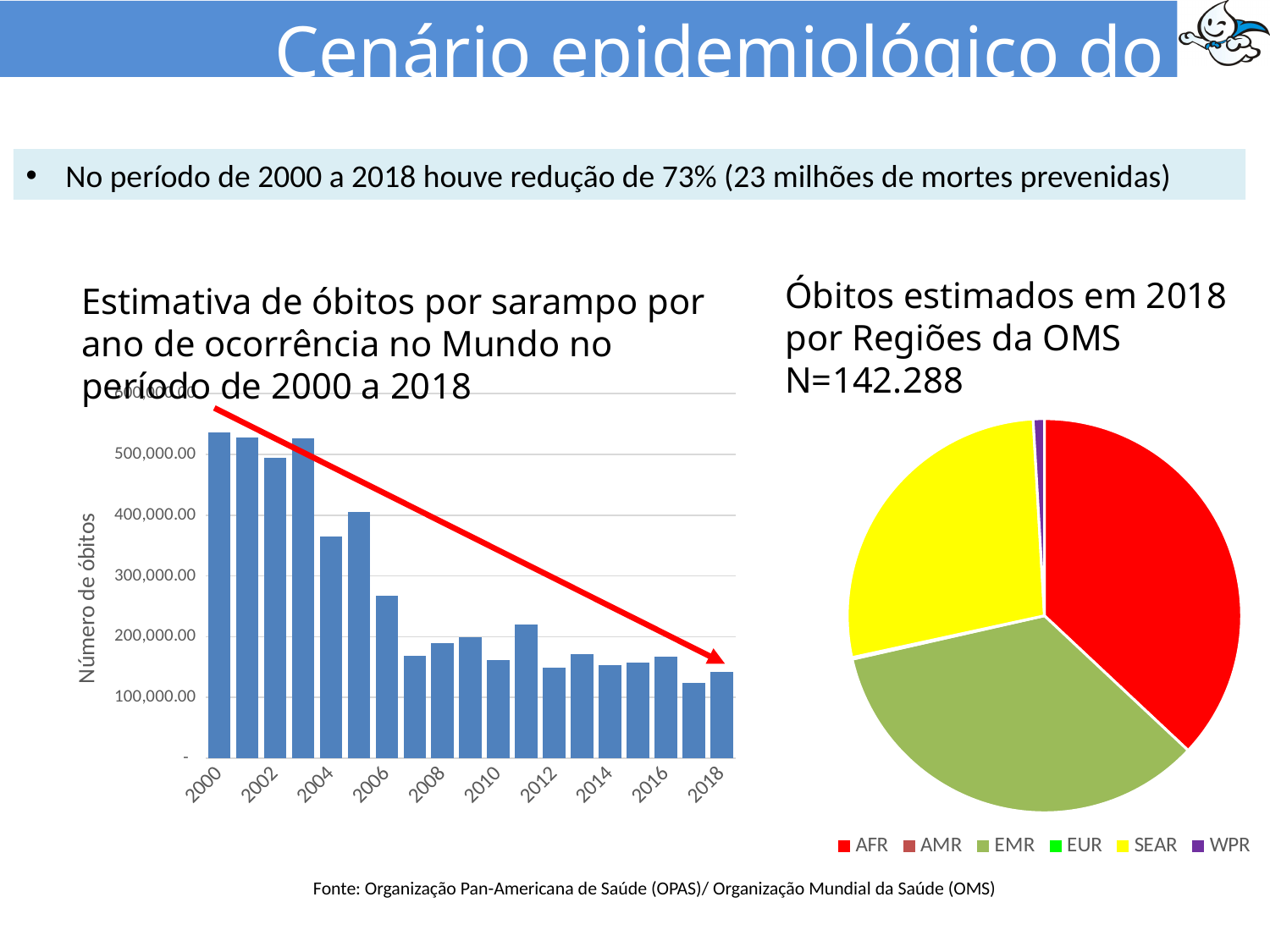
How many regions does the legend of the pie chart 'Óbitos estimados em 2018 por Regiões da OMS' list? 6 In the bar chart of estimated measles deaths by year, is the value for 2004 greater or less than 400,000.00? less In the bar chart of estimated measles deaths by year, is the value for 2006 greater or less than 300,000.00? less What kind of chart is the left chart, 'Estimativa de óbitos por sarampo por ano de ocorrência no Mundo no período de 2000 a 2018'? bar chart What total N is stated in the title of the pie chart 'Óbitos estimados em 2018 por Regiões da OMS'? N=142.288 In the bar chart of estimated measles deaths by year, how many years (bars) are plotted? 19 What kind of chart is the right chart, 'Óbitos estimados em 2018 por Regiões da OMS'? pie chart In the bar chart of estimated measles deaths by year, is the value for 2000 greater or less than 500,000.00? greater In the pie chart 'Óbitos estimados em 2018 por Regiões da OMS', which region has the largest slice? AFR In the bar chart of estimated measles deaths by year, which is larger, the value for 2005 or the value for 2004? 2005 In the bar chart of estimated measles deaths by year, do the values generally rise or fall from 2000 to 2018? fall In the bar chart of estimated measles deaths by year, which year has the lowest value? 2017